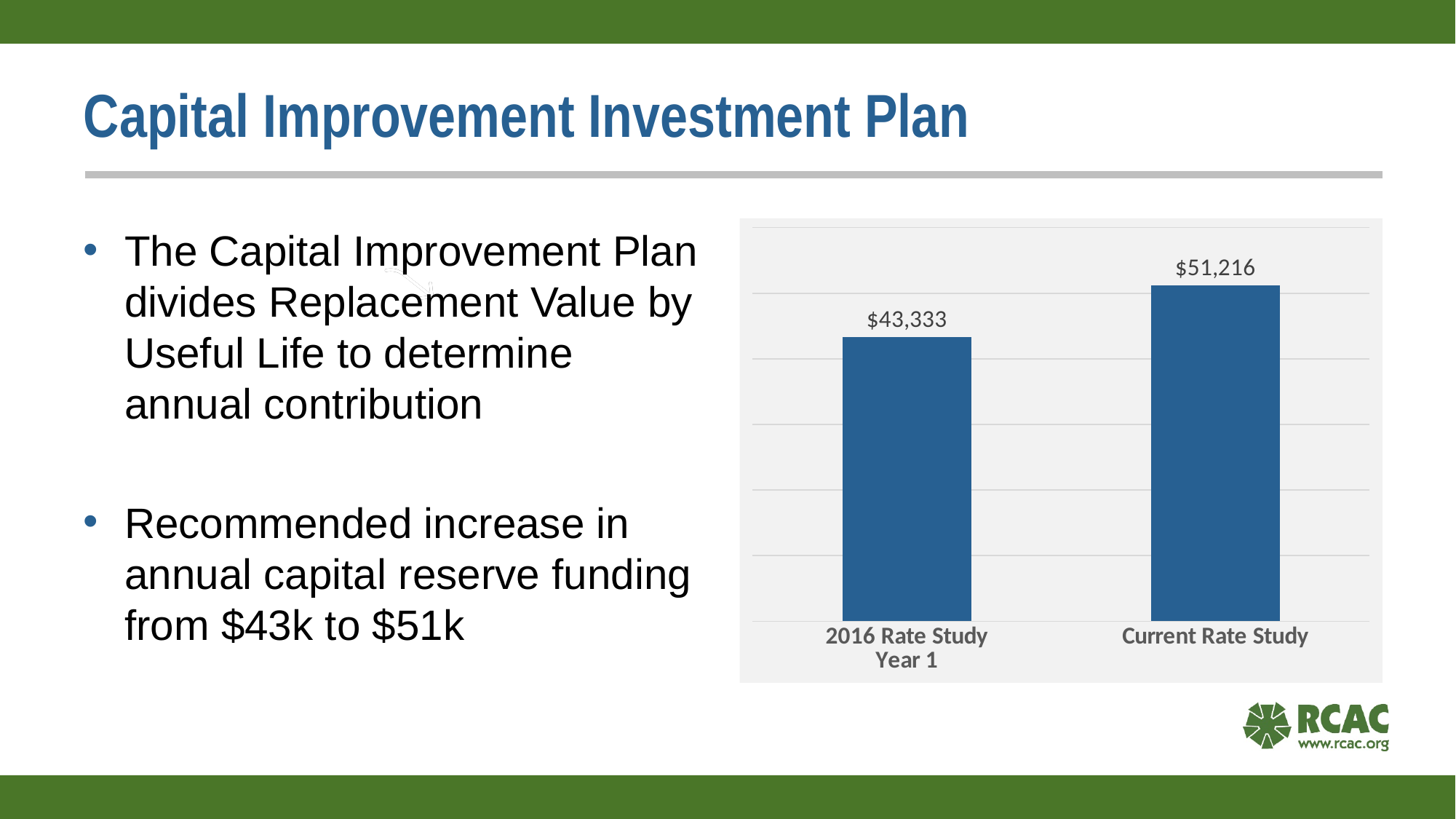
What kind of chart is shown on the slide? Bar chart What is the value for 2016 Rate Study Year 1? $43,333 Which category has the highest value? Current Rate Study What colour are the bars in the chart? Blue Do the values rise or fall from 2016 Rate Study Year 1 to Current Rate Study? Rise What is the label of the first category on the x axis? 2016 Rate Study Year 1 What is the value for Current Rate Study? $51,216 Which is larger, the value for 2016 Rate Study Year 1 or the value for Current Rate Study? Current Rate Study Which category has the lowest value? 2016 Rate Study Year 1 How many categories are shown in the chart? 2 What is the difference between the Current Rate Study value and the 2016 Rate Study Year 1 value? $7,883